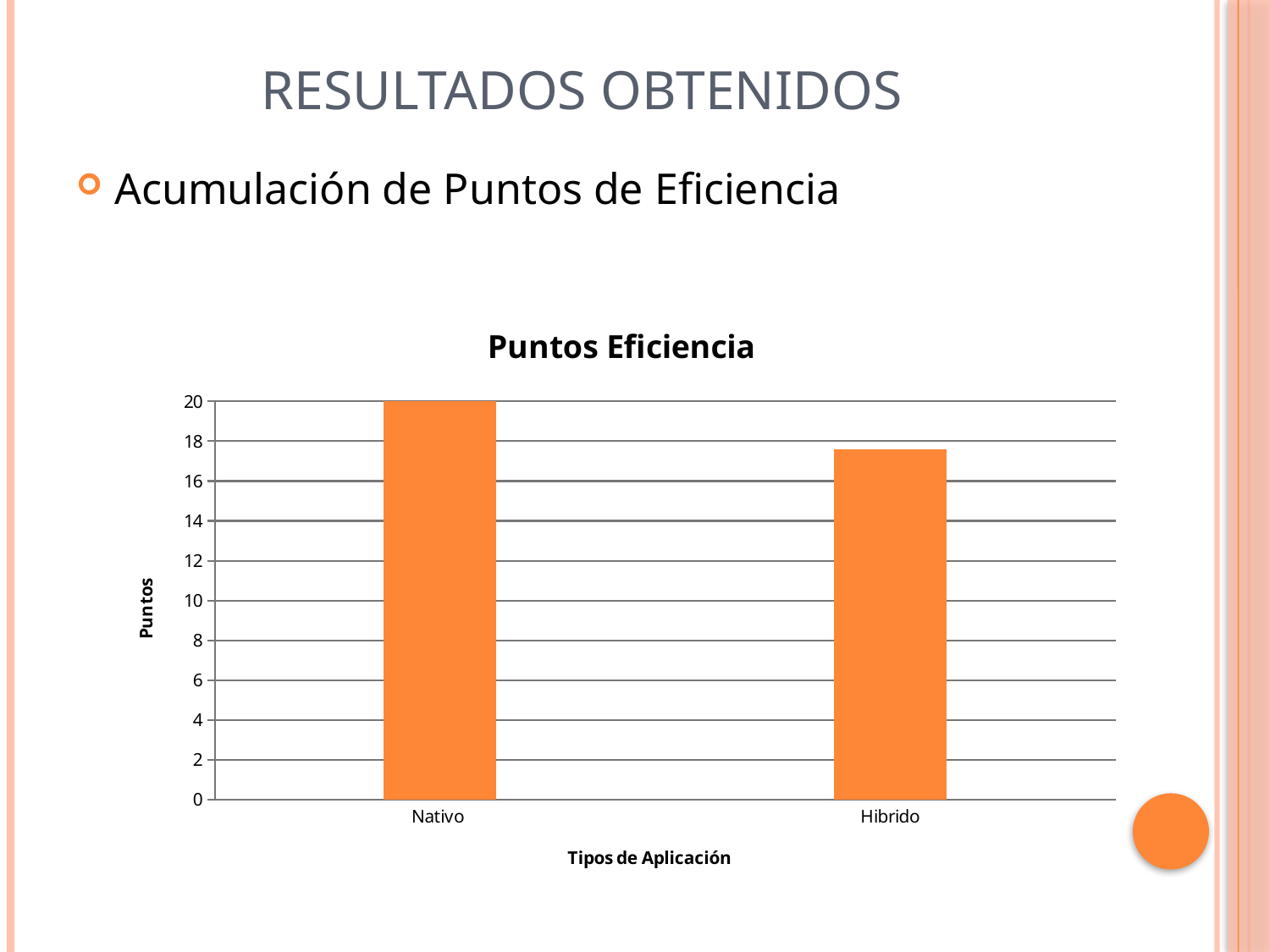
Which category has the lowest value in the Puntos Eficiencia chart? Hibrido Do the values rise or fall from Nativo to Hibrido along the x axis? fall Which is larger, the value for Nativo or the value for Hibrido? Nativo Is the value for Hibrido greater or less than 18? less Which category has the highest value in the Puntos Eficiencia chart? Nativo What type of chart is shown on the slide? bar chart Is the value for Hibrido greater or less than 16? greater How many categories are shown on the x axis of the chart? 2 What is the label of the x axis in the chart? Tipos de Aplicación What is the title of the chart? Puntos Eficiencia